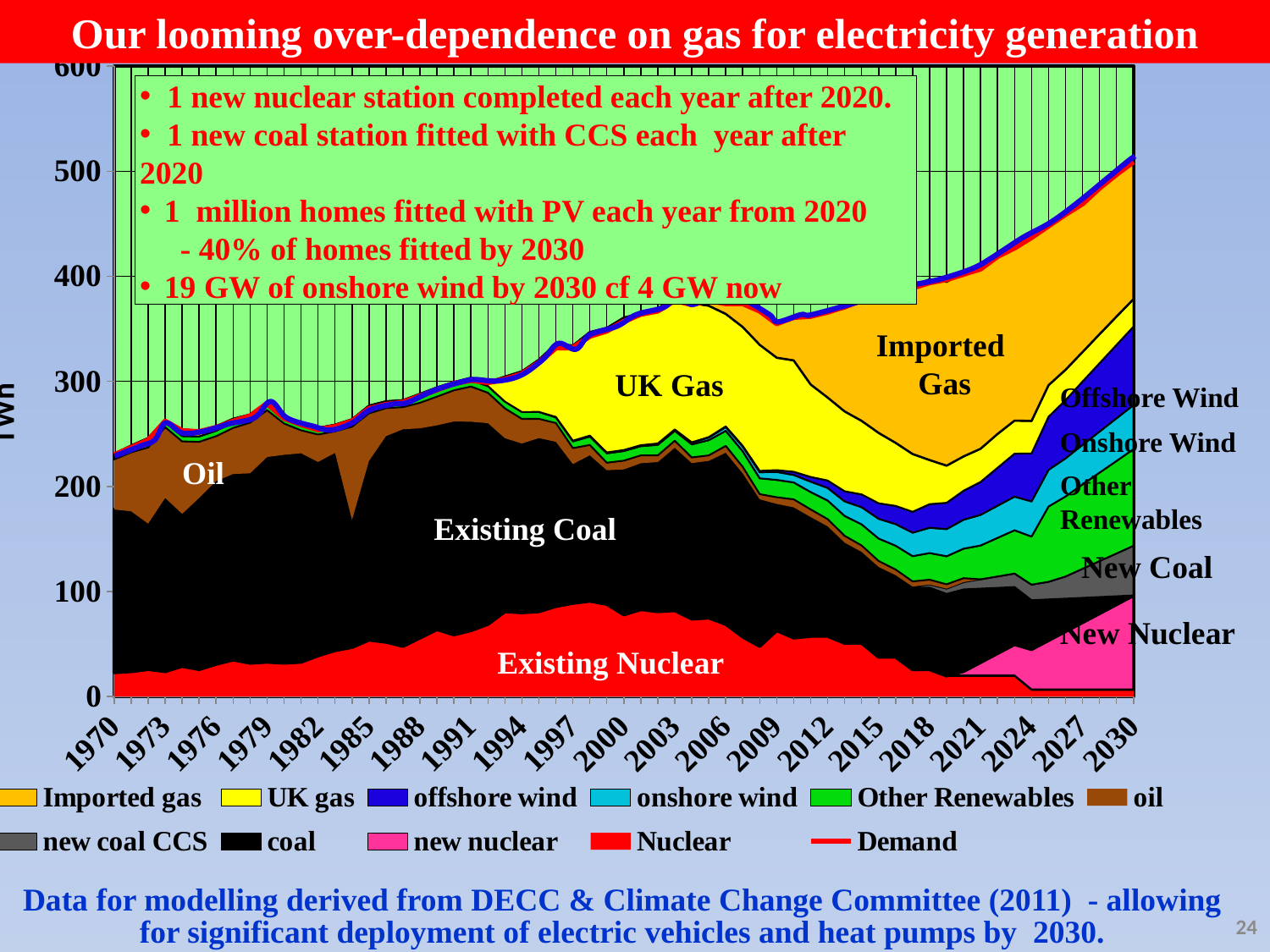
How many series does the legend list? 11 How many year labels are shown on the x axis? 21 What is the last year shown on the x axis? 2030 Is the total generation in 1970 greater or less than 300? less Is the total generation in 2030 greater or less than 400? greater What is the first year shown on the x axis? 1970 What is the title of the chart? Our looming over-dependence on gas for electricity generation Is the total generation in 1970 greater or less than 200? greater Which series is drawn as a line rather than an area in the legend? Demand Does the total generation rise or fall between 2018 and 2030? rise What is the highest value shown on the y axis? 600 What kind of chart is shown on the slide? stacked area chart